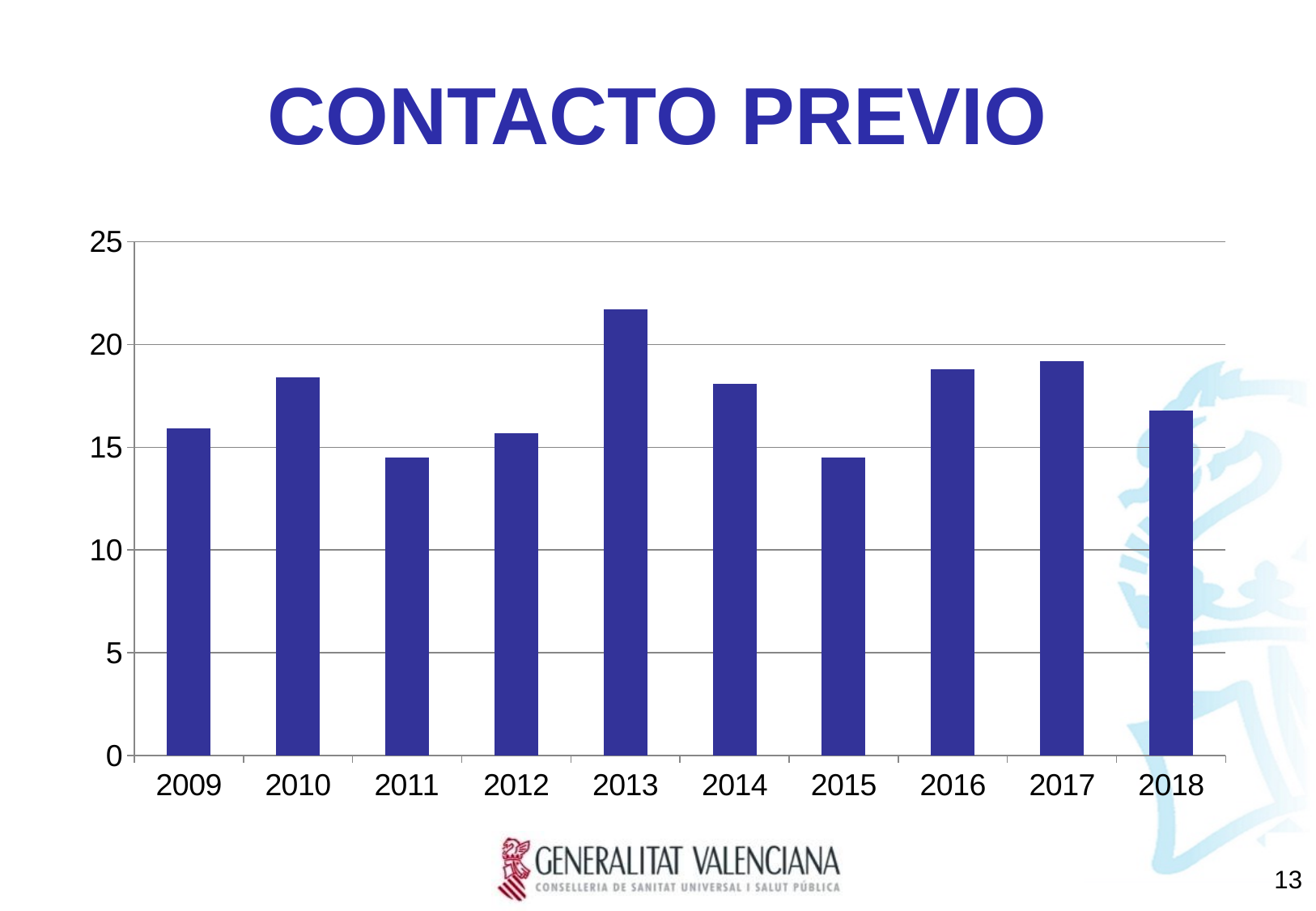
Which year has the larger value, 2017 or 2018? 2017 Which year has the highest bar in the chart? 2013 How many years are shown on the x axis of the chart? 10 Is the value for 2010 greater or less than 15? greater Is the value for 2013 greater or less than 20? greater What kind of chart is shown on the slide? bar chart What is the title of the chart? CONTACTO PREVIO Is the value for 2017 greater or less than 20? less Which year has the larger value, 2013 or 2014? 2013 Which year has the larger value, 2010 or 2012? 2010 Do the values rise or fall from 2013 to 2015? fall